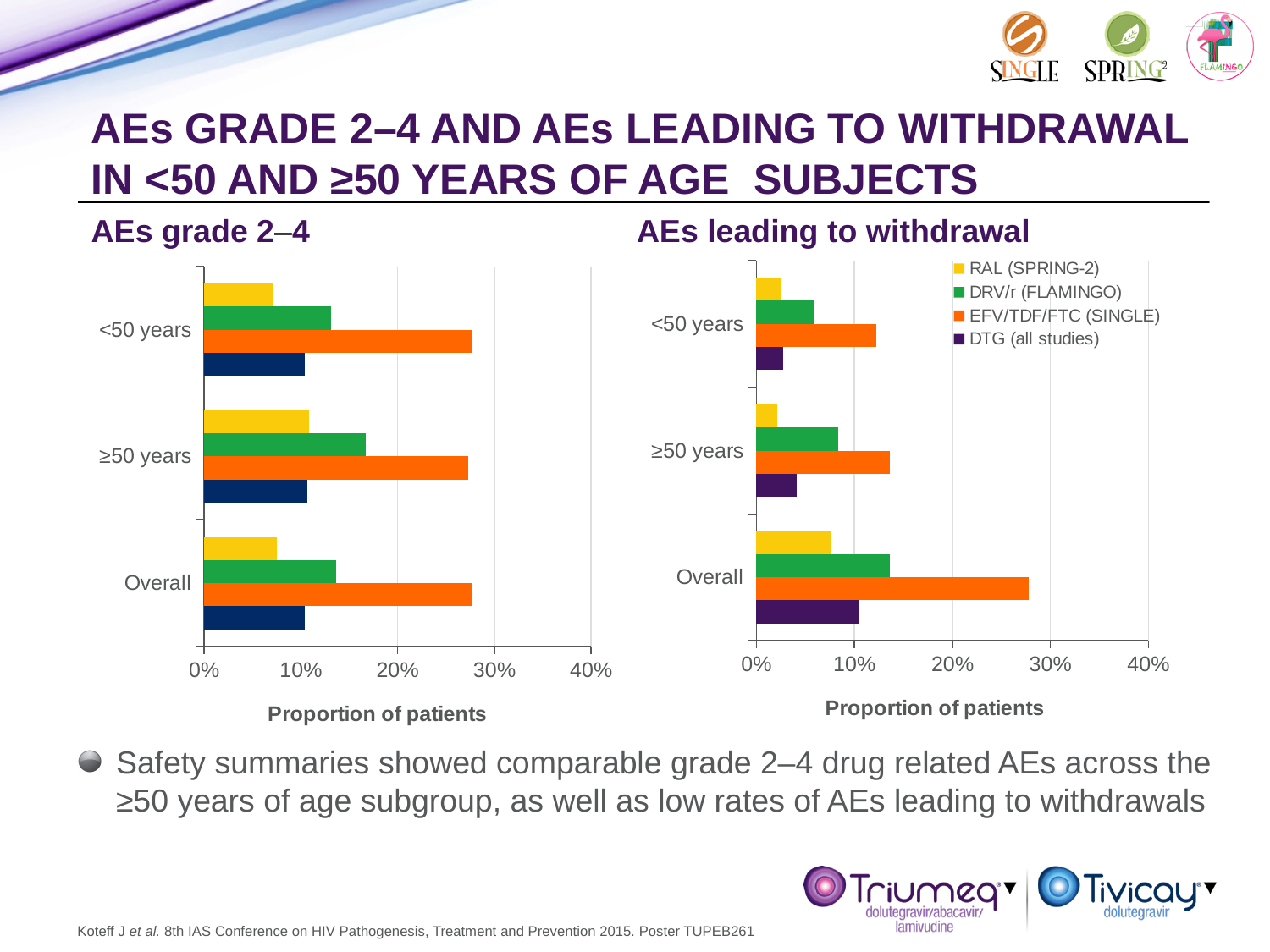
On the "AEs grade 2–4" chart, in the <50 years group, which is larger: EFV/TDF/FTC (SINGLE) or DTG (all studies)? EFV/TDF/FTC (SINGLE) What is the x-axis title of the "AEs leading to withdrawal" chart? Proportion of patients On the "AEs grade 2–4" chart, is the value for EFV/TDF/FTC (SINGLE) in the <50 years group greater or less than 20%? greater On the "AEs leading to withdrawal" chart, which series has the lowest value in the Overall group? RAL (SPRING-2) How many series does the legend on the "AEs leading to withdrawal" chart list? 4 On the "AEs grade 2–4" chart, which series has the highest value in the Overall group? EFV/TDF/FTC (SINGLE) On the "AEs leading to withdrawal" chart, in which age category is the EFV/TDF/FTC (SINGLE) value highest? Overall On the "AEs leading to withdrawal" chart, is the value for RAL (SPRING-2) in the <50 years group greater or less than 10%? less How many age categories are shown on the "AEs grade 2–4" chart? 3 On the "AEs grade 2–4" chart, is the value for DTG (all studies) in the Overall group greater or less than 20%? less What kind of chart is the "AEs grade 2–4" chart? bar chart